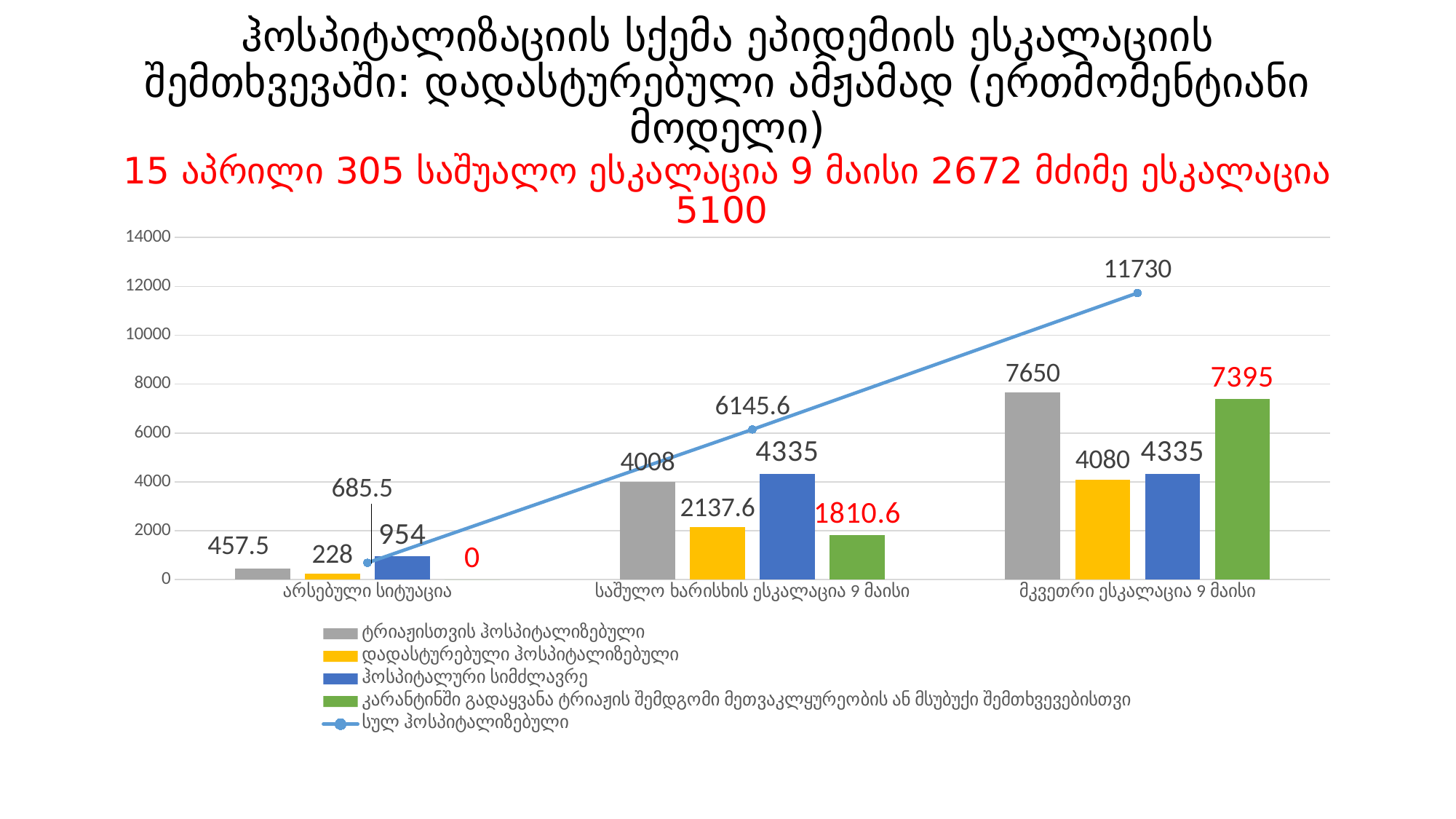
For which category is ტრიაჟისთვის ჰოსპიტალიზებული lowest? არსებული სიტუაცია What is the value of დადასტურებული ჰოსპიტალიზებული for საშუალო ხარისხის ესკალაცია 9 მაისი? 2137.6 For which category is the სულ ჰოსპიტალიზებული line highest? მკვეთრი ესკალაცია 9 მაისი How many series does the legend list? 5 What is the value of ტრიაჟისთვის ჰოსპიტალიზებული for მკვეთრი ესკალაცია 9 მაისი? 7650 What kind of chart is this? Combined bar and line chart What is the difference between the სულ ჰოსპიტალიზებული values for მკვეთრი ესკალაცია 9 მაისი and საშუალო ხარისხის ესკალაცია 9 მაისი? 5584.4 What is the value of the სულ ჰოსპიტალიზებული line for არსებული სიტუაცია? 685.5 Does the სულ ჰოსპიტალიზებული line rise or fall across the categories from left to right? Rises How many categories are shown on the x axis? 3 Which is larger for მკვეთრი ესკალაცია 9 მაისი: ტრიაჟისთვის ჰოსპიტალიზებული or კარანტინში გადაყვანა? ტრიაჟისთვის ჰოსპიტალიზებული What is the value of the green series (კარანტინში გადაყვანა) for არსებული სიტუაცია? 0